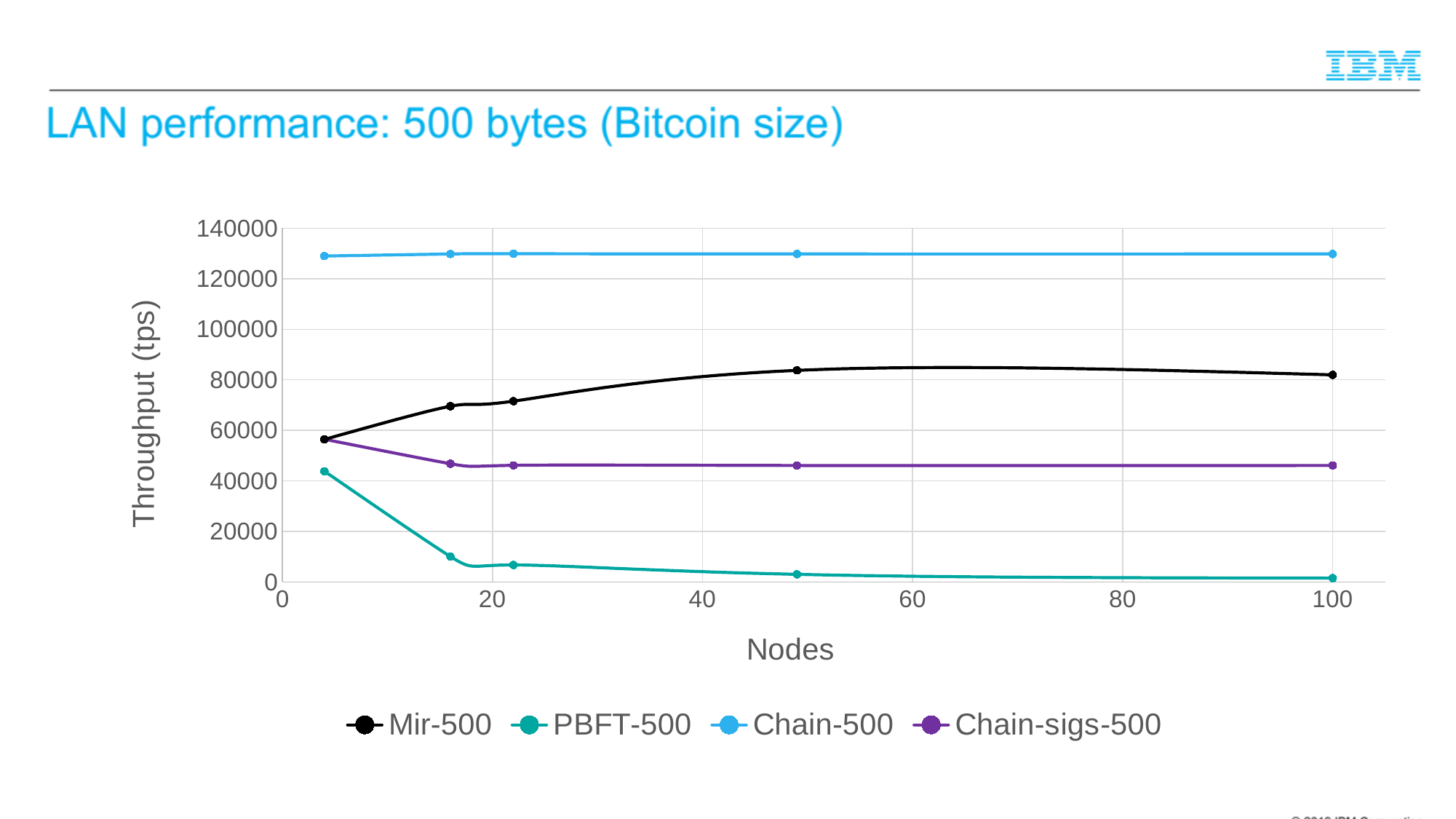
What is the label of the y axis? Throughput (tps) How many data points are plotted for the Mir-500 series? 5 Which series has the highest throughput at 100 nodes? Chain-500 Which series has the lowest throughput at 100 nodes? PBFT-500 What kind of chart is shown on the slide? line chart At 100 nodes, which has the higher throughput: Mir-500 or Chain-sigs-500? Mir-500 How many series does the legend list? 4 Is the throughput of Mir-500 at 100 nodes greater or less than 60000? greater Is the throughput of Chain-500 at 100 nodes greater or less than 120000? greater Is the throughput of PBFT-500 at 100 nodes greater or less than 20000? less Does the throughput of PBFT-500 rise or fall as the number of nodes increases? fall